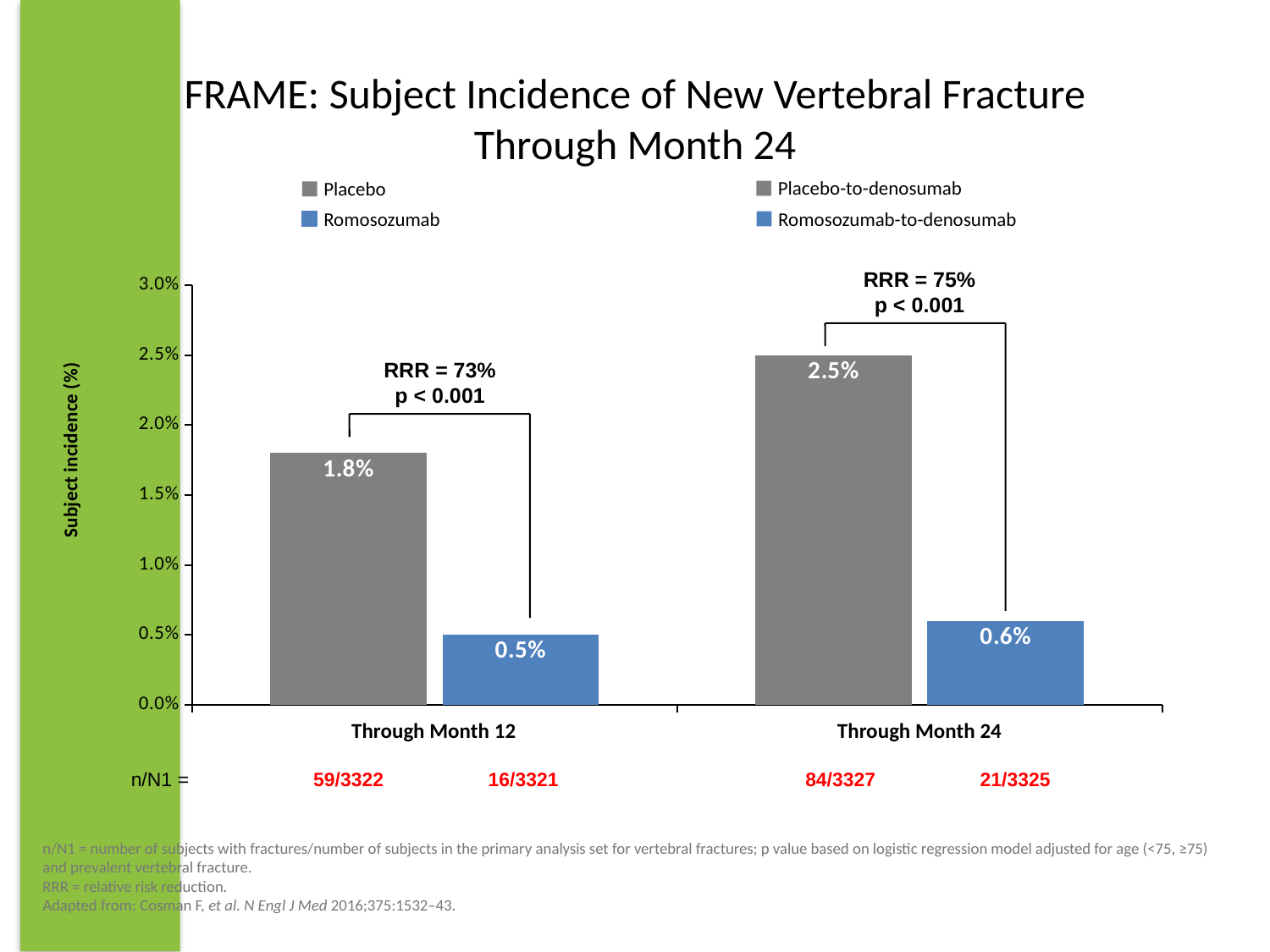
What kind of chart is shown on the slide? Bar chart Which bar shows the lowest subject incidence? Romosozumab (Through Month 12) Which is larger: the subject incidence for Placebo through Month 12 or for Placebo-to-denosumab through Month 24? Placebo-to-denosumab through Month 24 What is the subject incidence for Romosozumab through Month 12? 0.5% What is the label of the y axis? Subject incidence (%) Which bar shows the highest subject incidence? Placebo-to-denosumab (Through Month 24) What is the difference in subject incidence between Placebo-to-denosumab and Romosozumab-to-denosumab through Month 24? 1.9% What is the subject incidence for Romosozumab-to-denosumab through Month 24? 0.6% What is the subject incidence for Placebo-to-denosumab through Month 24? 2.5% How many series does the legend list? 4 What is the subject incidence for Placebo through Month 12? 1.8% What is the difference in subject incidence between Placebo and Romosozumab through Month 12? 1.3%